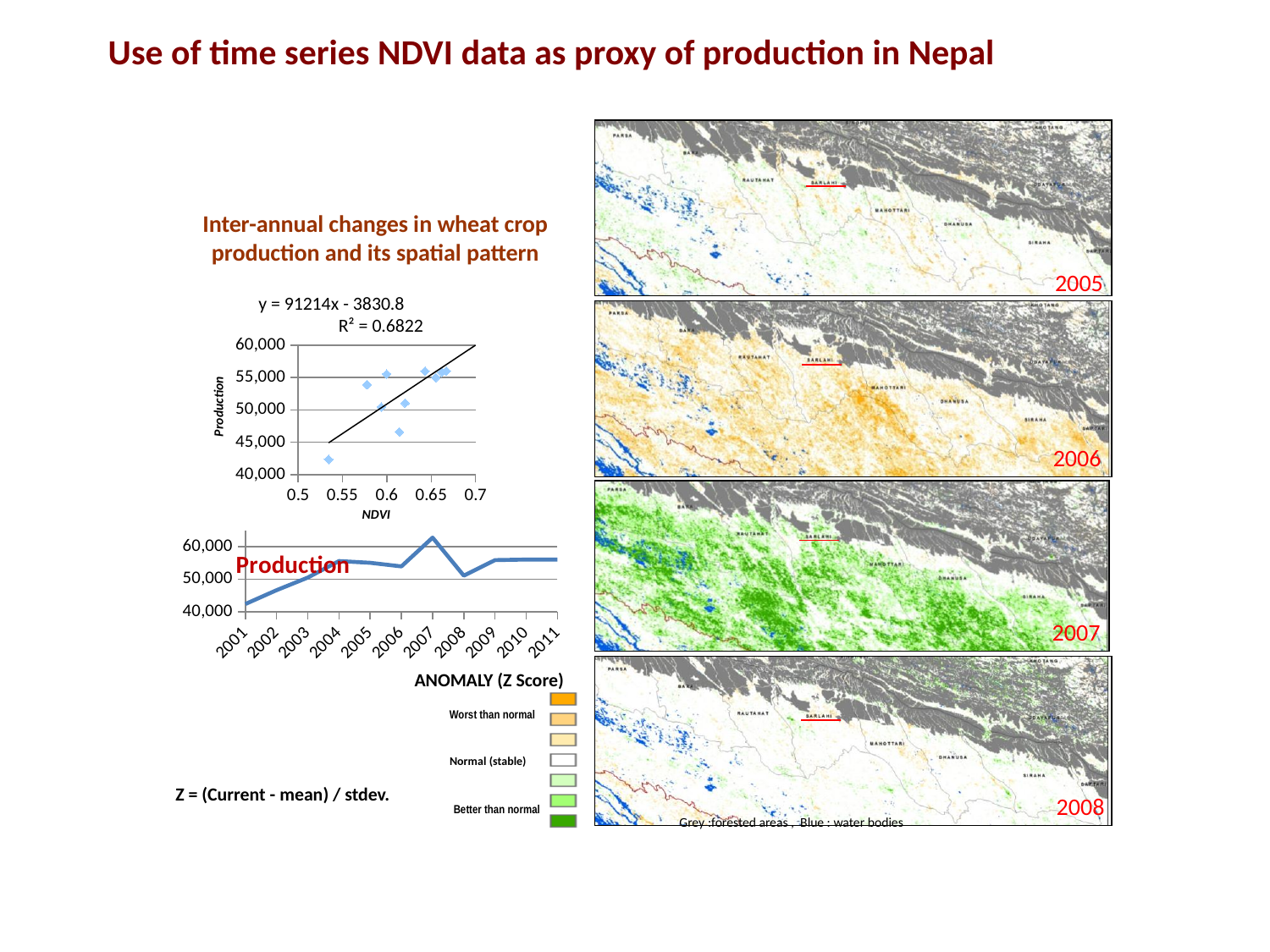
What kind of chart is the lower chart showing Production from 2001 to 2011? line chart In the lower Production line chart, how many years are shown on the x axis? 11 In the lower Production line chart, is the value for 2007 greater or less than 60,000? greater In the lower Production line chart, which year has the highest production? 2007 In the lower Production line chart, is the value for 2001 greater or less than 50,000? less In the lower Production line chart, which year has the lowest production? 2001 In the lower Production line chart, is the value for 2004 greater or less than 50,000? greater What is the trendline equation shown on the upper scatter chart of Production against NDVI? y = 91214x - 3830.8 What R² value is shown on the upper scatter chart of Production against NDVI? R² = 0.6822 In the lower Production line chart, which year has the higher production, 2002 or 2003? 2003 In the lower Production line chart, does production rise or fall from 2001 to 2005? rise What kind of chart is the upper chart plotting Production against NDVI? scatter chart